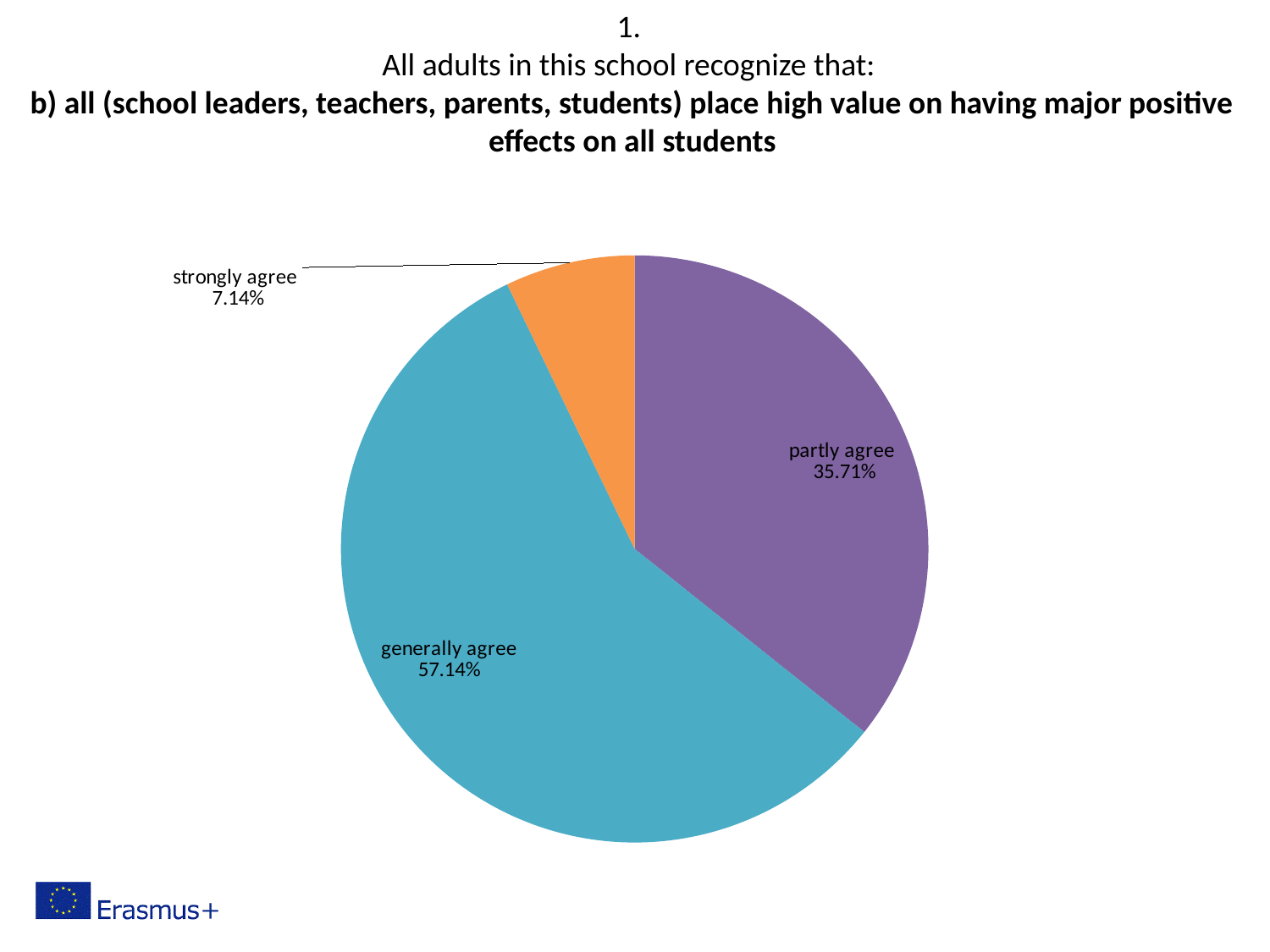
What kind of chart is shown on the slide? pie chart What is the difference in percentage points between "generally agree" and "partly agree"? 21.43 What is the difference in percentage points between "partly agree" and "strongly agree"? 28.57 What percentage of respondents chose "strongly agree"? 7.14% What colour is the "generally agree" slice? teal/blue Which response category has the smallest share of the pie? strongly agree What percentage of respondents chose "generally agree"? 57.14% How many slices does the pie chart have? 3 What percentage of respondents chose "partly agree"? 35.71% Which response category has the largest share of the pie? generally agree Which is larger, the share for "partly agree" or the share for "strongly agree"? partly agree What colour is the "strongly agree" slice? orange